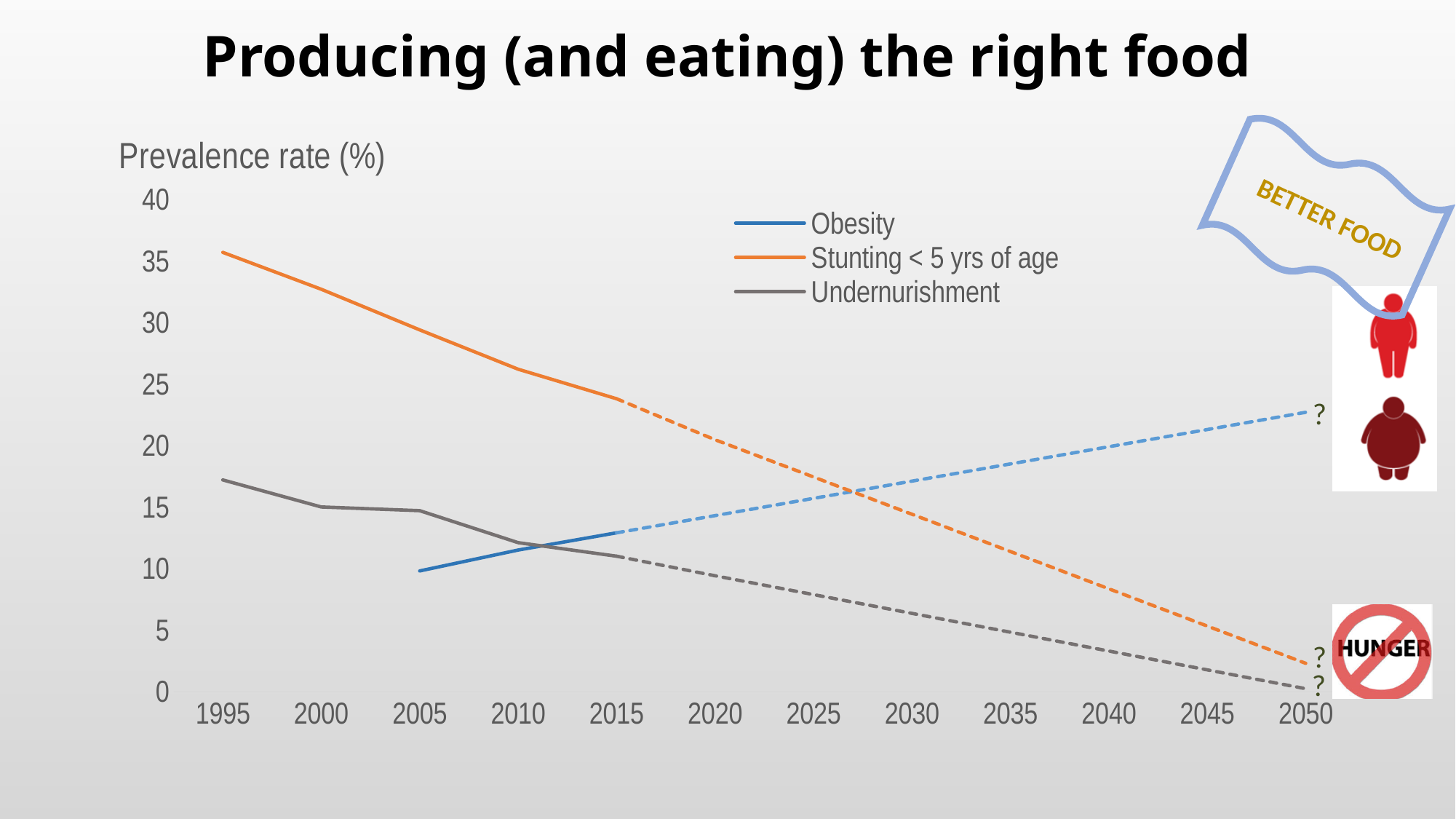
Does the Stunting < 5 yrs of age line rise or fall from 1995 to 2050? fall How many series does the legend list? 3 What is the label of the vertical axis? Prevalence rate (%) In 2050, which is larger: Obesity or Stunting < 5 yrs of age? Obesity What kind of chart is shown on the slide? line chart Is the value for Stunting < 5 yrs of age in 1995 greater or less than 30? greater Which series has the highest value in 1995? Stunting < 5 yrs of age Does the Obesity line rise or fall from 2005 to 2050? rise In 2005, which is larger: Obesity or Undernurishment? Undernurishment Is the value for Undernurishment in 2015 greater or less than 15? less Is the value for Obesity in 2050 greater or less than 20? greater Which series has the lowest value in 2050? Undernurishment